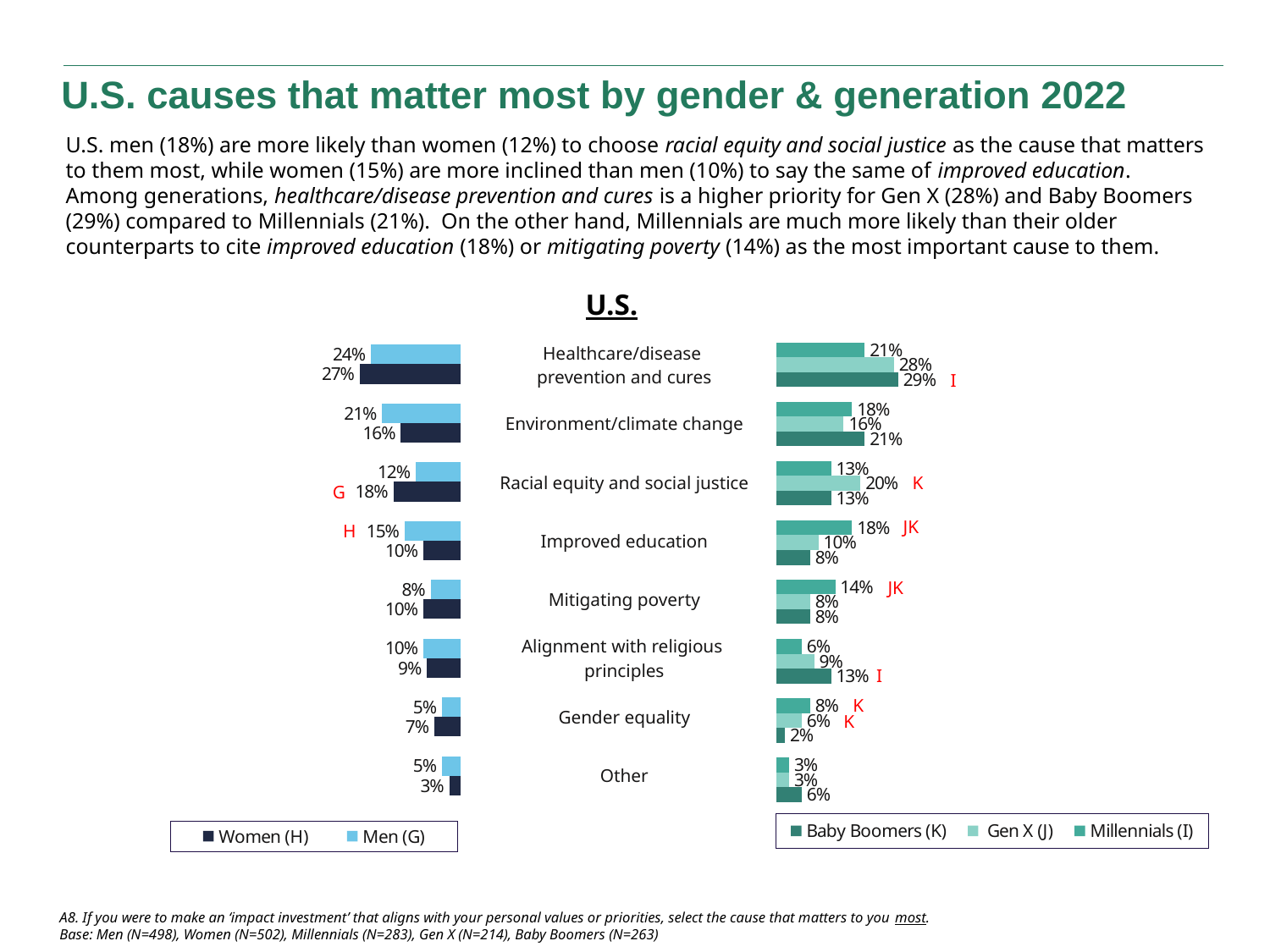
In the right-hand chart (by generation), what percentage of Gen X chose Racial equity and social justice? 20% In the left-hand chart (by gender), what is the larger of the two values shown for Healthcare/disease prevention and cures? 27% In the right-hand chart (by generation), what is the difference between Millennials and Gen X for Mitigating poverty? 6% In the right-hand chart (by generation), what percentage of Baby Boomers chose Healthcare/disease prevention and cures? 29% How many series does the legend of the right-hand chart (by generation) list? 3 How many causes (categories) are shown in the left-hand chart (by gender)? 8 In the right-hand chart (by generation), which is larger for Alignment with religious principles: Baby Boomers or Millennials? Baby Boomers In the right-hand chart (by generation), what percentage of Millennials chose Improved education? 18% In the right-hand chart (by generation), which cause has the highest value for Millennials? Healthcare/disease prevention and cures What are the two legend entries of the left-hand chart (by gender)? Women (H) and Men (G) In the right-hand chart (by generation), what percentage of Baby Boomers chose Gender equality? 2% What type of chart is the left-hand chart (by gender)? Bar chart